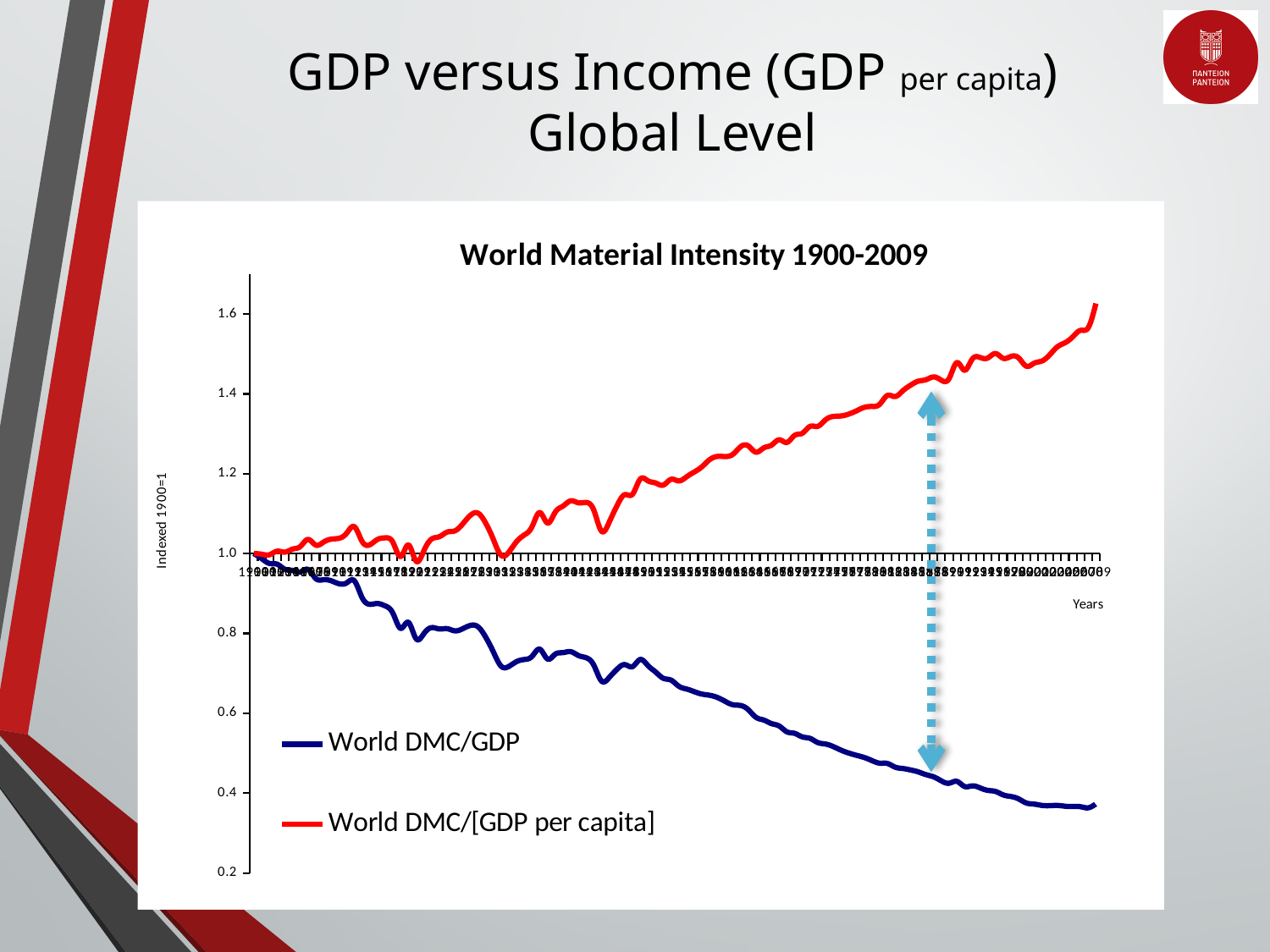
Which series has the higher value in 2009, World DMC/GDP or World DMC/[GDP per capita]? World DMC/[GDP per capita] What type of chart is shown on the slide? line chart Is the value for World DMC/[GDP per capita] in 2009 greater or less than 1.2? greater How many series does the chart's legend list? 2 Is the value for World DMC/GDP in 2009 greater or less than 0.6? less What is the label on the vertical axis of the chart? Indexed 1900=1 Is the value for World DMC/[GDP per capita] in 2009 greater or less than 1.4? greater What is the title of the chart? World Material Intensity 1900-2009 Does the World DMC/[GDP per capita] series rise or fall from 1900 to 2009? rise What value do both series have in 1900, the base year of the index? 1.0 Does the World DMC/GDP series rise or fall from 1900 to 2009? fall